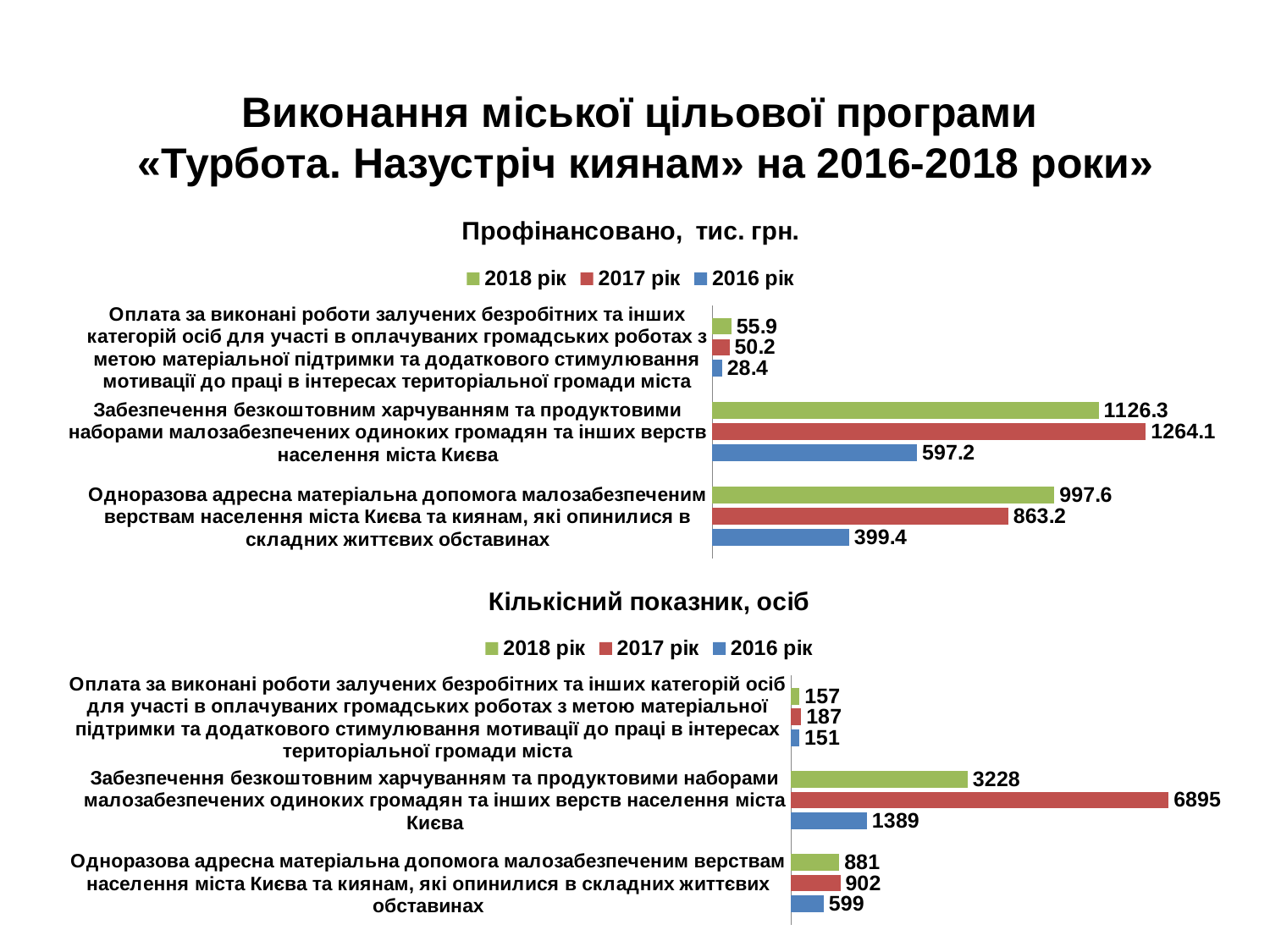
What kind of chart is the chart titled «Кількісний показник, осіб»? Bar chart In the chart titled «Профінансовано, тис. грн.», what is the 2016 рік value for «Одноразова адресна матеріальна допомога...»? 399.4 How many categories are shown in the chart titled «Кількісний показник, осіб»? 3 In the chart titled «Кількісний показник, осіб», which category has the highest 2017 рік value? Забезпечення безкоштовним харчуванням та продуктовими наборами... In the chart titled «Кількісний показник, осіб», what is the 2016 рік value for «Оплата за виконані роботи залучених безробітних...»? 151 In the chart titled «Профінансовано, тис. грн.», for «Забезпечення безкоштовним харчуванням...», which year has the larger value: 2018 рік or 2017 рік? 2017 рік How many series does the legend of the chart titled «Профінансовано, тис. грн.» list? 3 In the chart titled «Профінансовано, тис. грн.», which category has the lowest 2018 рік value? Оплата за виконані роботи залучених безробітних та інших категорій осіб... In the chart titled «Профінансовано, тис. грн.», what is the 2017 рік value for «Забезпечення безкоштовним харчуванням та продуктовими наборами...»? 1264.1 In the chart titled «Профінансовано, тис. грн.», what is the difference between the 2018 рік and 2016 рік values for «Одноразова адресна матеріальна допомога...»? 598.2 In the chart titled «Кількісний показник, осіб», what is the 2017 рік value for «Забезпечення безкоштовним харчуванням та продуктовими наборами...»? 6895 In the chart titled «Кількісний показник, осіб», what is the difference between the 2017 рік and 2018 рік values for «Одноразова адресна матеріальна допомога...»? 21